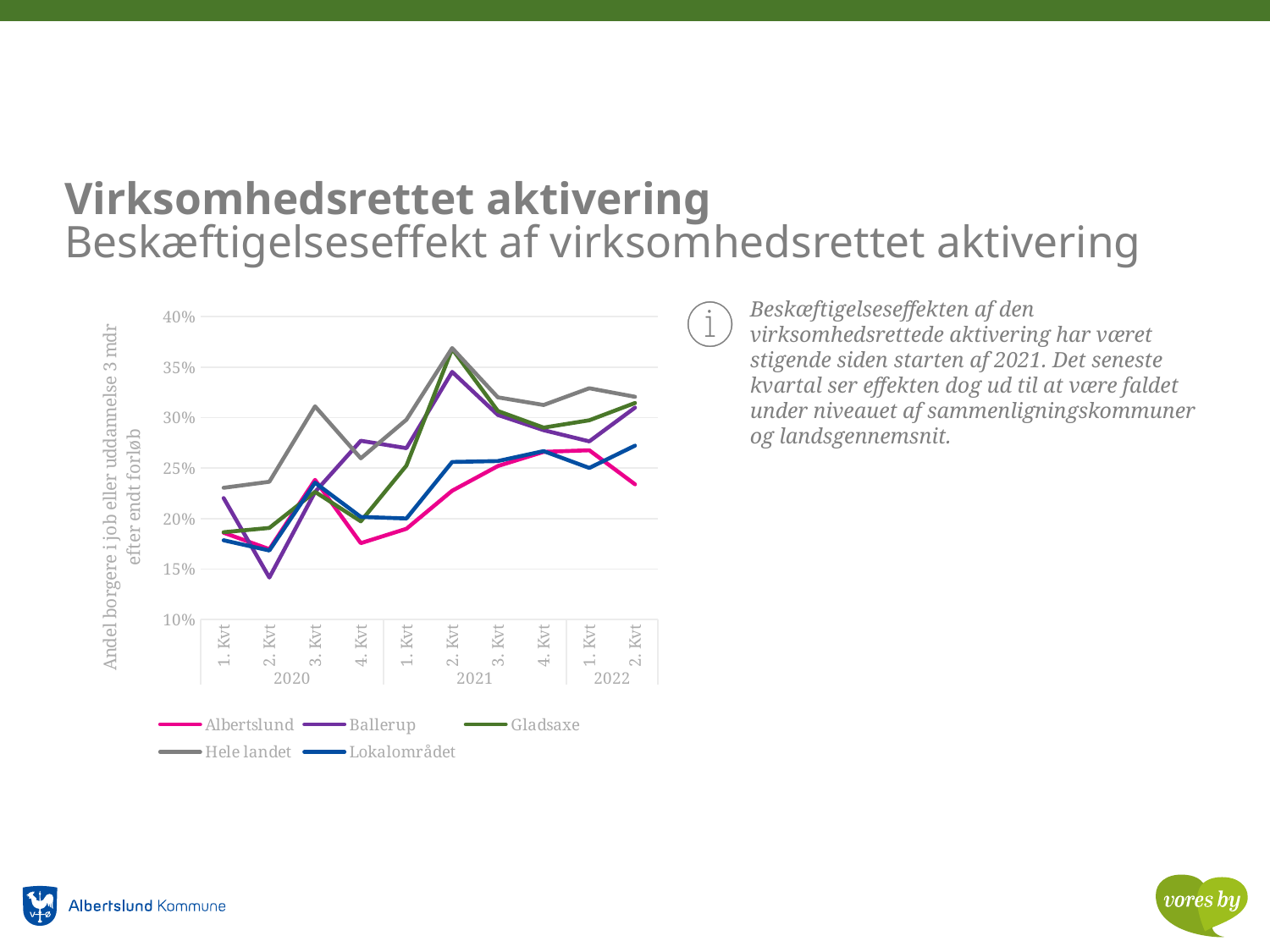
Which series has the lowest value in 2. Kvt 2020? Ballerup What kind of chart is shown on the slide? line chart How many quarters are plotted along the x axis? 10 In 2. Kvt 2022, which is larger: the value for Albertslund or the value for Hele landet? Hele landet Is the value for Gladsaxe in 2. Kvt 2022 greater or less than 30%? greater Is the value for Ballerup in 2. Kvt 2020 greater or less than 15%? less Is the value for Albertslund in 2. Kvt 2022 greater or less than 25%? less What is the label on the y axis of the chart? Andel borgere i job eller uddannelse 3 mdr efter endt forløb Which series has the highest value in 1. Kvt 2022? Hele landet How many series does the legend list? 5 Does the Albertslund line rise or fall from 1. Kvt 2022 to 2. Kvt 2022? fall